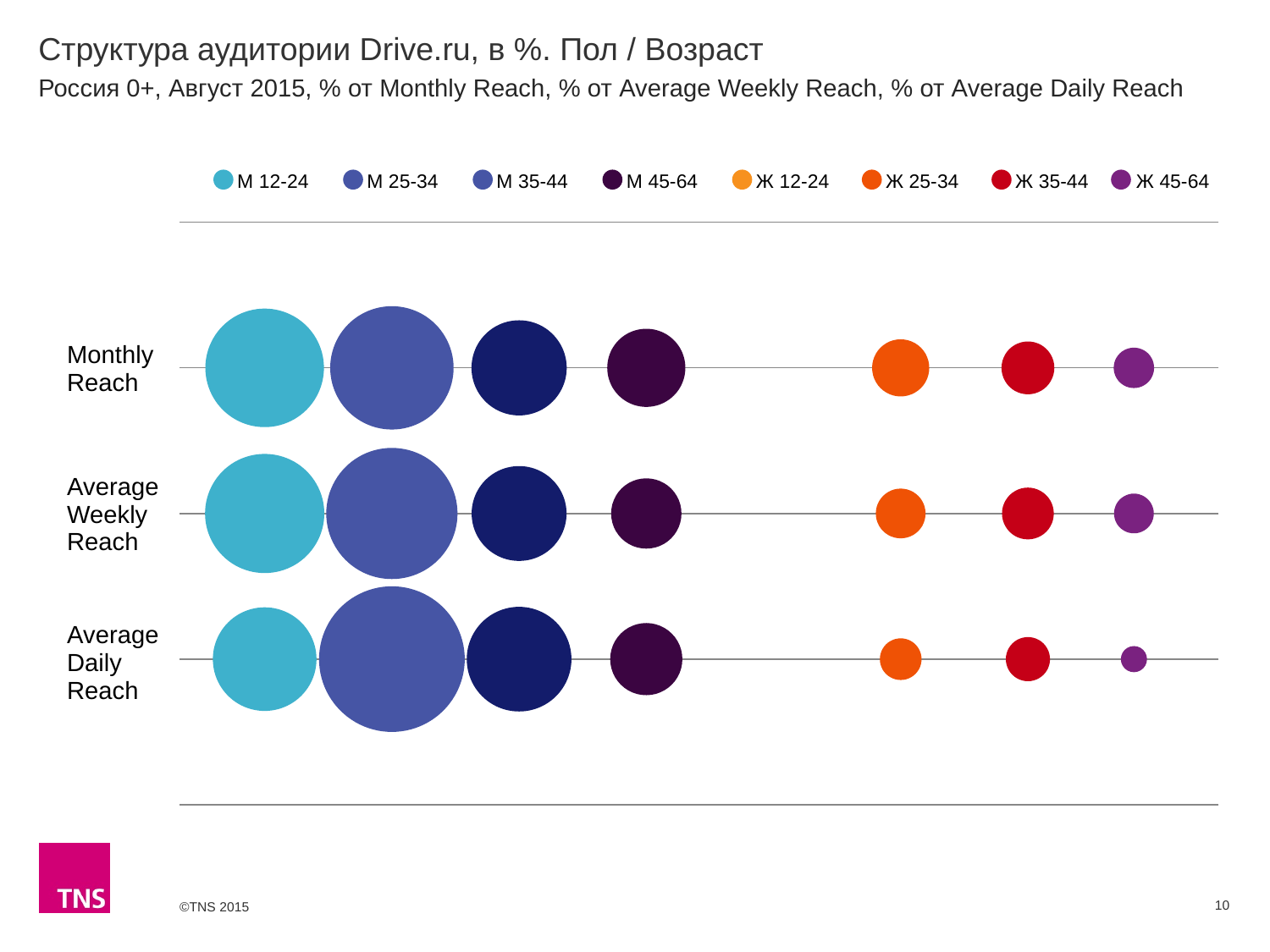
In the Average Weekly Reach row, which bubble is larger: М 35-44 or Ж 35-44? М 35-44 How many reach categories (rows) are plotted on the chart? 3 Which series has the smallest bubble in the Average Daily Reach row? Ж 45-64 What kind of chart is shown on the slide? Bubble chart Which series has the largest bubble in the Average Daily Reach row? М 25-34 Which series in the legend has no visible bubble in any row? Ж 12-24 What are the labels of the three rows on the chart, from top to bottom? Monthly Reach, Average Weekly Reach, Average Daily Reach Which series has the smallest bubble in the Monthly Reach row? Ж 45-64 In the Average Daily Reach row, which bubble is larger: М 25-34 or М 12-24? М 25-34 How many series does the legend list? 8 In the Monthly Reach row, which bubble is larger: М 12-24 or Ж 25-34? М 12-24 What is the title of the chart on the slide? Структура аудитории Drive.ru, в %. Пол / Возраст